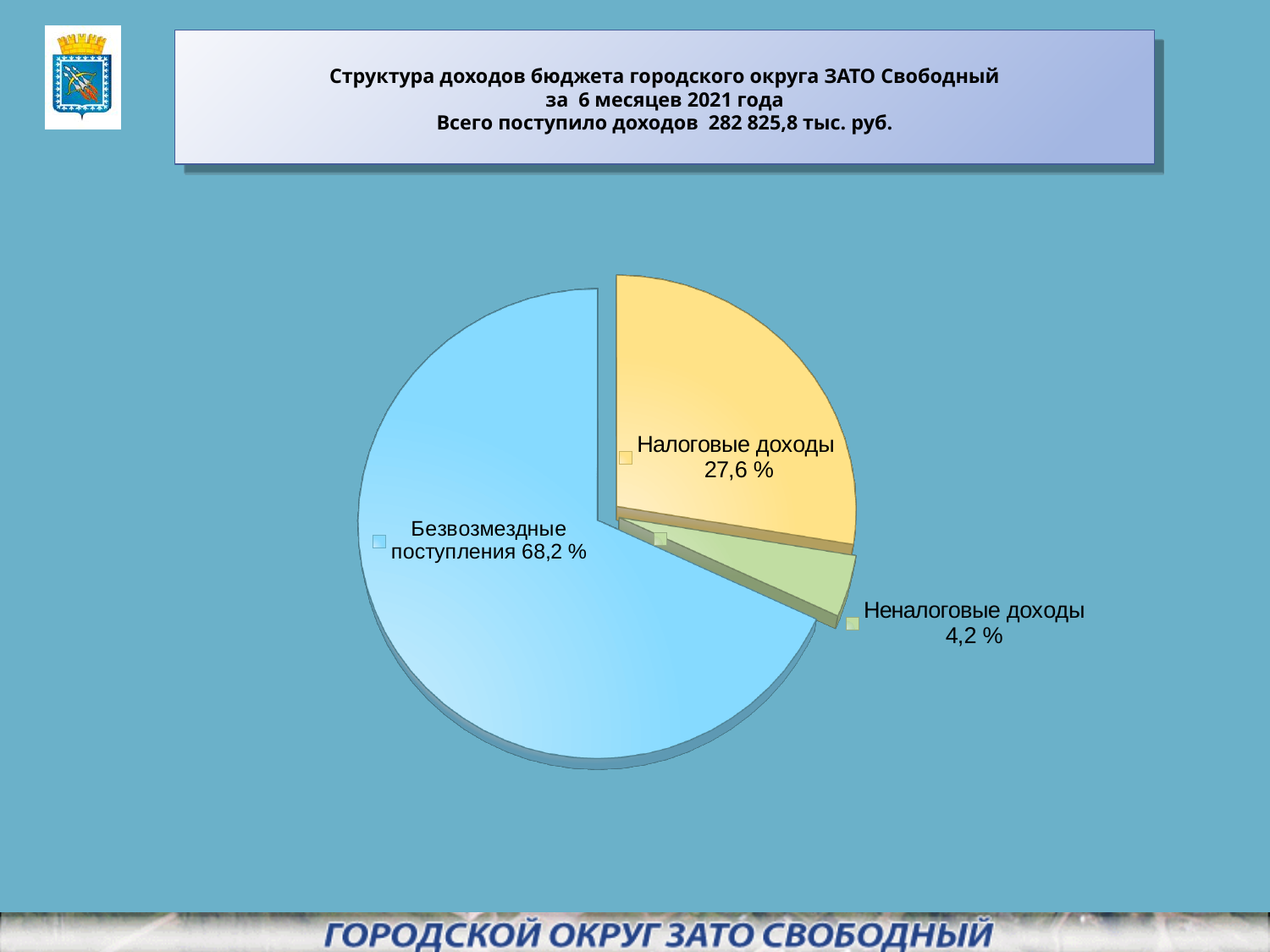
What period does the chart title say the income structure covers? 6 месяцев 2021 года Which slice of the pie is the smallest? Неналоговые доходы Which slice of the pie is the largest? Безвозмездные поступления What kind of chart is shown on the slide? pie chart What share of the pie is labelled for Неналоговые доходы? 4,2 % What is the difference in percentage points between Безвозмездные поступления and Налоговые доходы? 40,6 What total income amount is stated in the slide title? 282 825,8 тыс. руб. What share of the pie is labelled for Налоговые доходы? 27,6 % What is the difference in percentage points between Налоговые доходы and Неналоговые доходы? 23,4 Which is larger: Налоговые доходы or Неналоговые доходы? Налоговые доходы How many slices does the pie chart have? 3 What share of the pie is labelled for Безвозмездные поступления? 68,2 %